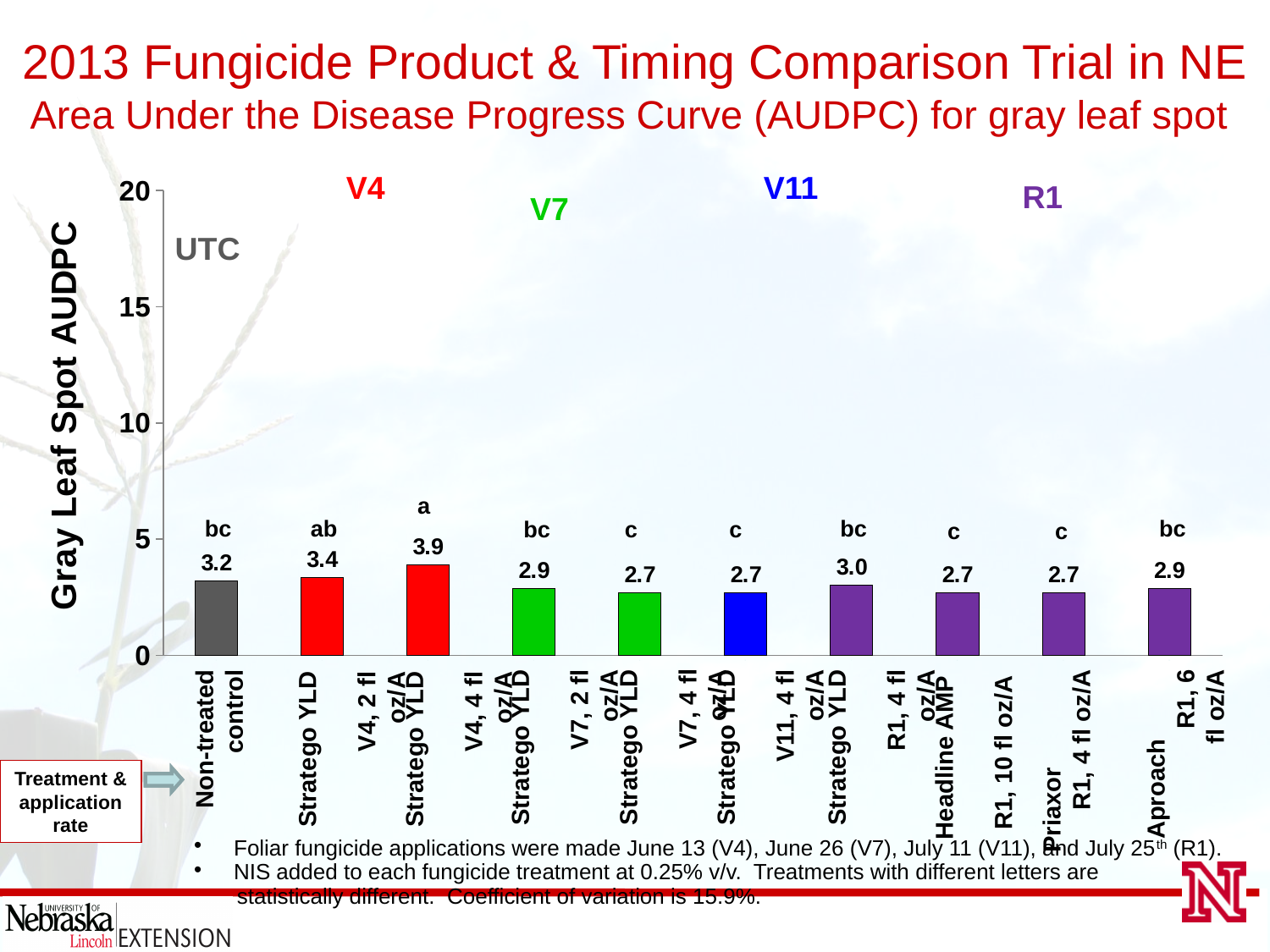
What type of chart is shown on the slide? bar chart What is the difference in AUDPC between Stratego YLD at V4, 4 fl oz/A and the Non-treated control? 0.7 Which has a higher AUDPC value: Stratego YLD at V4, 2 fl oz/A or Stratego YLD at V7, 2 fl oz/A? Stratego YLD at V4, 2 fl oz/A What is the AUDPC value for Headline AMP applied at R1 at 10 fl oz/A? 2.7 What is the AUDPC value for Aproach applied at R1 at 6 fl oz/A? 2.9 What is the Gray Leaf Spot AUDPC value for the Non-treated control? 3.2 What is the label of the y-axis of the chart? Gray Leaf Spot AUDPC Is the AUDPC value for the Non-treated control greater or less than 5? less Which treatment has the highest Gray Leaf Spot AUDPC value? Stratego YLD, V4, 4 fl oz/A What statistical letter grouping is shown above the Stratego YLD V4, 4 fl oz/A bar? a What is the AUDPC value for Stratego YLD applied at V4 at 4 fl oz/A? 3.9 How many treatments (bars) are shown in the chart? 10